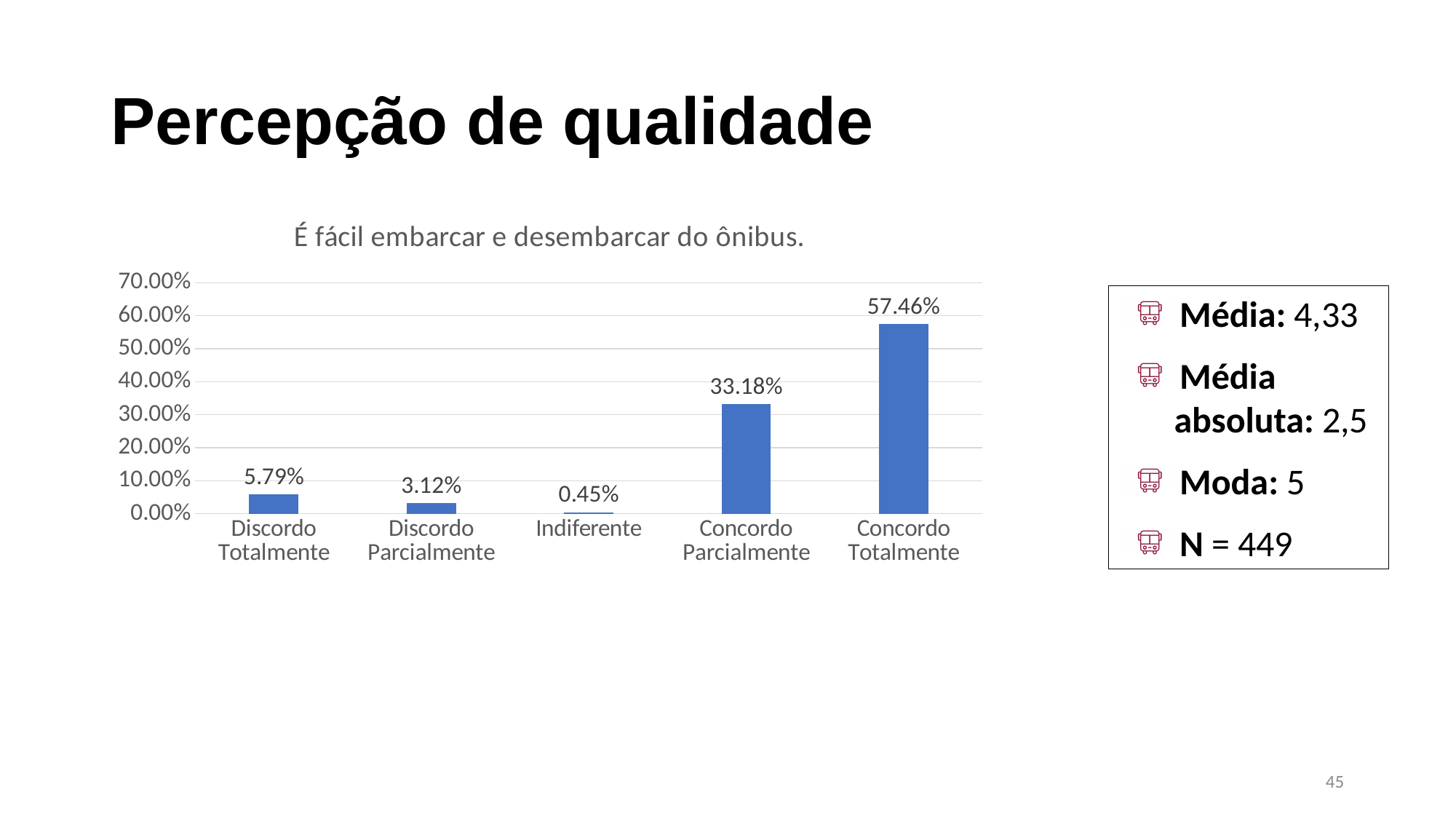
What is the value for Concordo Totalmente? 57.46% What is the title of the chart? É fácil embarcar e desembarcar do ônibus. What is the value for Indiferente? 0.45% What is the difference between Discordo Totalmente and Discordo Parcialmente? 2.67% What is the difference between Concordo Totalmente and Concordo Parcialmente? 24.28% What kind of chart is shown? bar chart What is the value for Discordo Parcialmente? 3.12% Which category has the highest value? Concordo Totalmente How many categories are shown on the x axis? 5 Is the value for Concordo Parcialmente greater or less than 30.00%? greater Which is larger, Discordo Totalmente or Discordo Parcialmente? Discordo Totalmente Which category has the lowest value? Indiferente